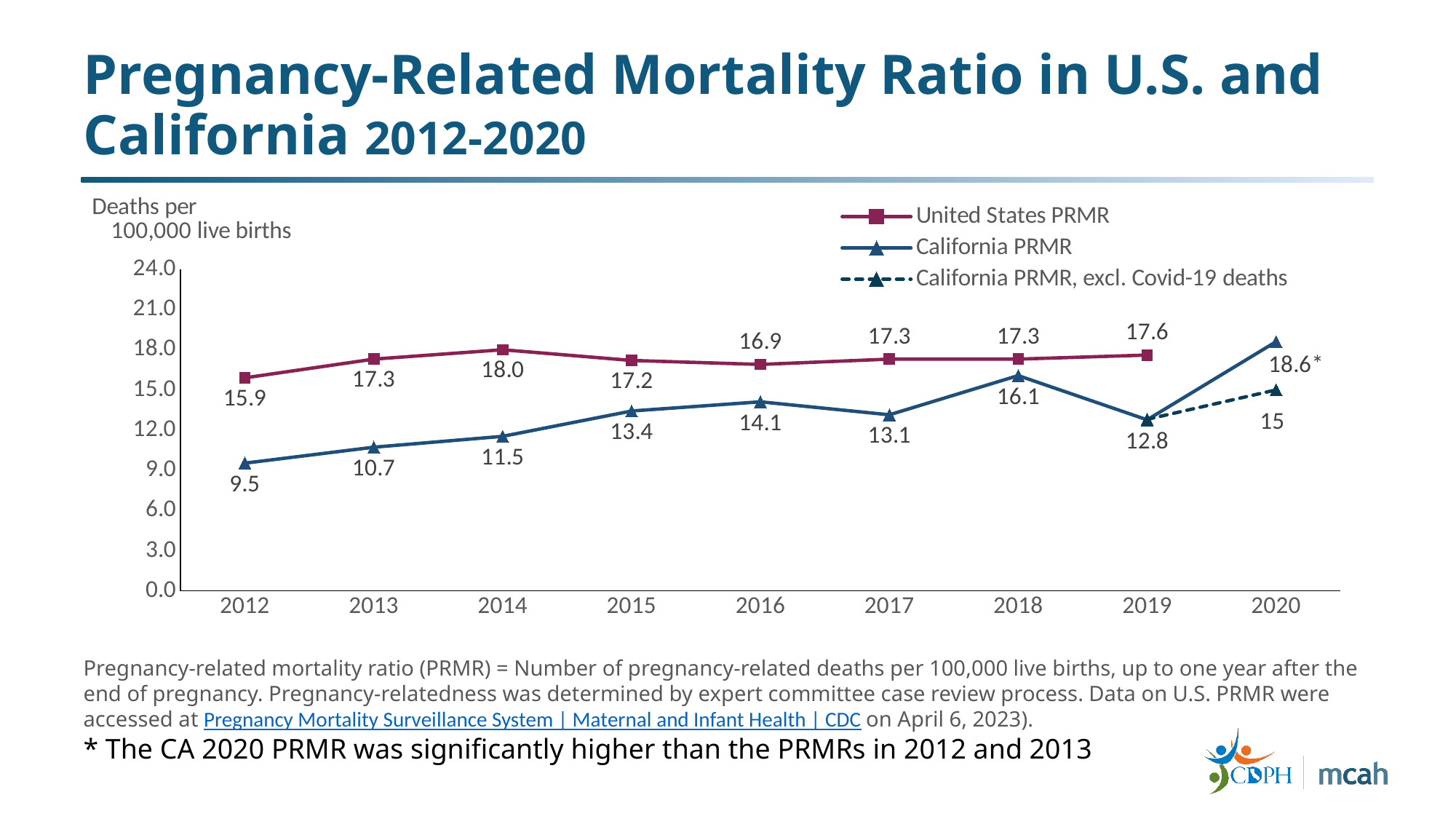
What is the difference between the United States PRMR and the California PRMR in 2019? 4.8 How many years are shown on the x axis? 9 How many series does the legend list? 3 What kind of chart is shown on the slide? Line chart What was the California PRMR in 2012? 9.5 What was the California PRMR excluding Covid-19 deaths in 2020? 15 Which was higher in 2018, the United States PRMR or the California PRMR? United States PRMR What was the California PRMR in 2020? 18.6 What was the United States PRMR in 2014? 18.0 Did the California PRMR rise or fall from 2018 to 2019? Fall In which year was the California PRMR lowest? 2012 In which year was the United States PRMR highest? 2014